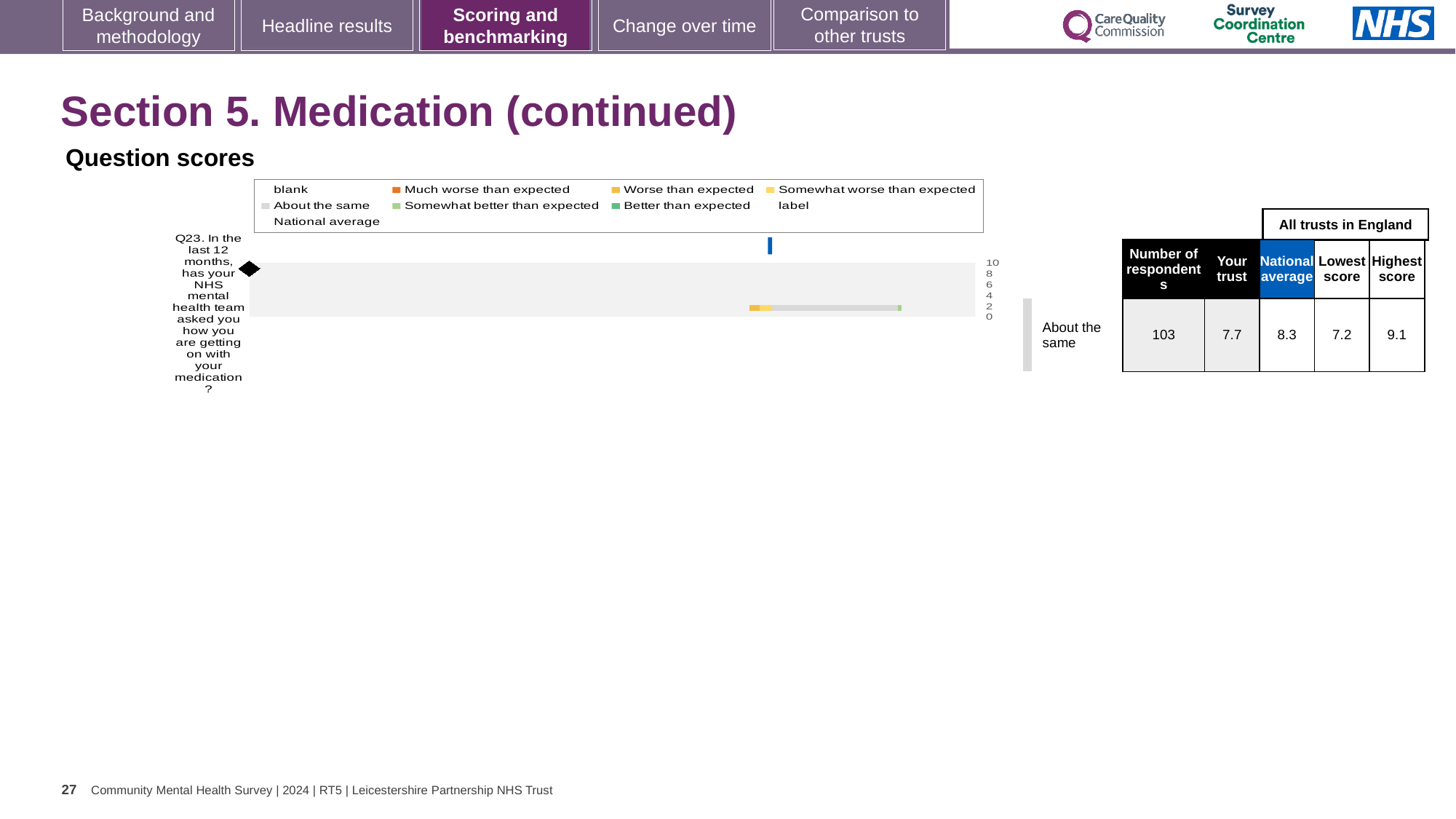
How many survey questions are plotted in the Question scores chart? 1 What benchmark category is shown next to the Q23 bar? About the same What is the national average score for Q23? 8.3 What is the difference between the highest score and the lowest score for Q23? 1.9 How many respondents answered Q23? 103 Which is larger for Q23: the 'Your trust' score or the national average? National average Is the 'Your trust' score for Q23 greater or less than 6 on the chart axis? greater What is the 'Your trust' score for Q23? 7.7 What is the highest score among all trusts in England for Q23? 9.1 What kind of chart is shown under 'Question scores'? bar chart What is the lowest score among all trusts in England for Q23? 7.2